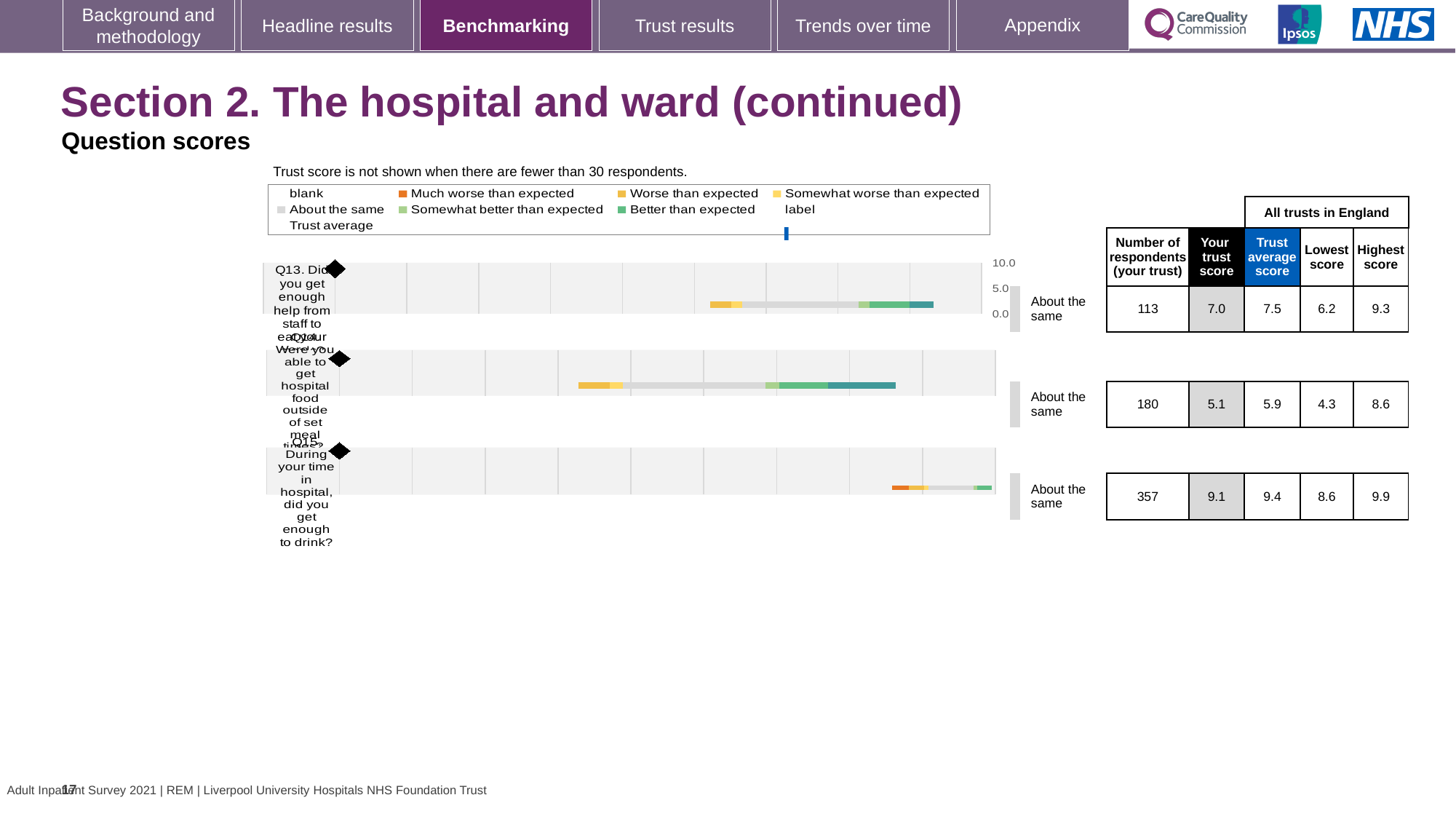
Which question has the highest 'Your trust score'? Q15 For Q14, which is larger: your trust score or the trust average score? Trust average score What kind of chart is used to show the question scores on this slide? bar chart What is the highest score across all trusts in England for Q15? 9.9 For Q13, what is the difference between the trust average score and your trust score? 0.5 What benchmark category is shown next to the bar for Q13? About the same What is the lowest score across all trusts in England for Q14? 4.3 Which question has the lowest 'Your trust score'? Q14 What is the 'Your trust score' for Q13? 7.0 How many entries does the chart legend list? 9 How many questions (Q13, Q14, Q15) are plotted in the chart? 3 How many respondents does the table show for Q14? 180